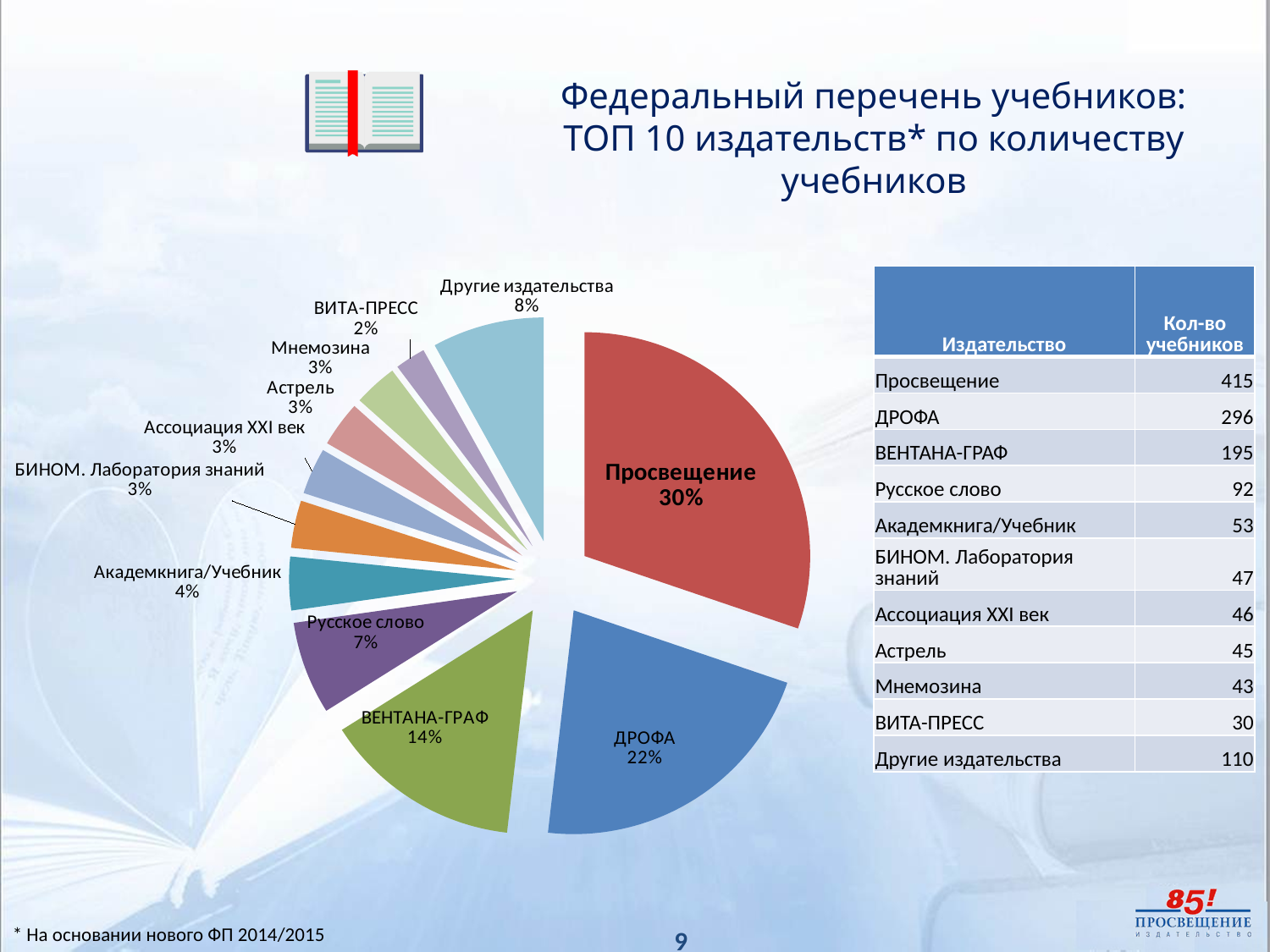
What percentage is shown for Русское слово in the pie chart? 7% Which publisher has the smallest slice of the pie chart? ВИТА-ПРЕСС Which publisher has the largest slice of the pie chart? Просвещение By how many percentage points does the Просвещение share exceed the ДРОФА share? 8 percentage points What colour is the Просвещение slice in the pie chart? Red What percentage is shown for Другие издательства in the pie chart? 8% How many slices does the pie chart have? 11 What percentage is shown for ДРОФА in the pie chart? 22% What share of the pie does Просвещение hold? 30% What kind of chart is shown on the slide? Pie chart What percentage is shown for ВЕНТАНА-ГРАФ in the pie chart? 14% Which slice is larger, ДРОФА or ВЕНТАНА-ГРАФ? ДРОФА